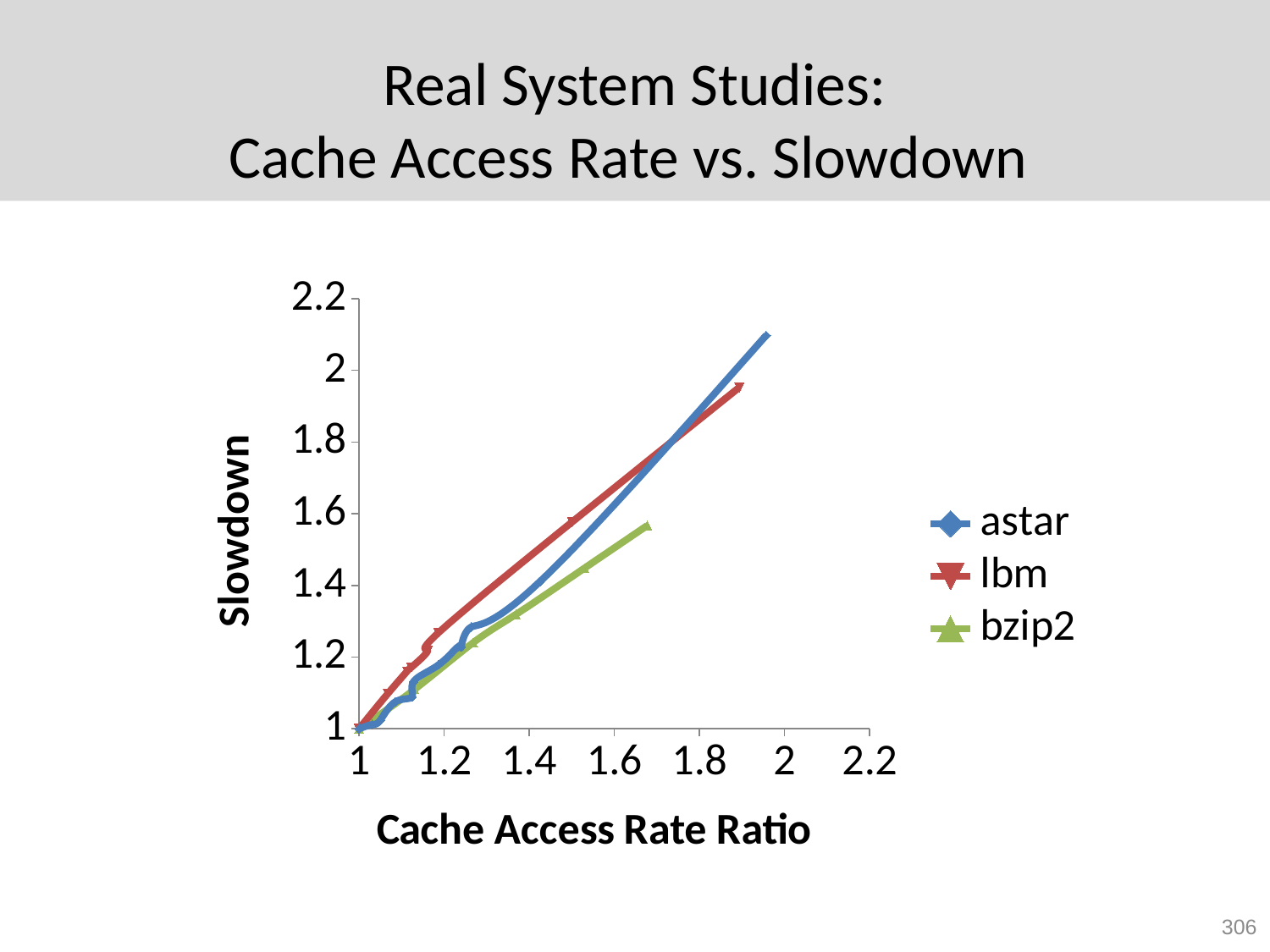
Is the highest slowdown reached by bzip2 greater or less than 1.6? less Does the slowdown for bzip2 rise or fall as the cache access rate ratio increases? rise What is the label of the x axis? Cache Access Rate Ratio Which series has the lowest slowdown at its right-most point? bzip2 Does the slowdown for astar rise or fall as the cache access rate ratio increases? rise Which series reaches the highest slowdown value on the chart? astar Is the highest slowdown reached by astar greater or less than 2? greater Which series are listed in the legend? astar, lbm, bzip2 At a cache access rate ratio of 1.4, which series has the larger slowdown, lbm or bzip2? lbm What kind of chart is shown on the slide? line chart Is the highest slowdown reached by lbm greater or less than 2? less How many series does the legend list? 3